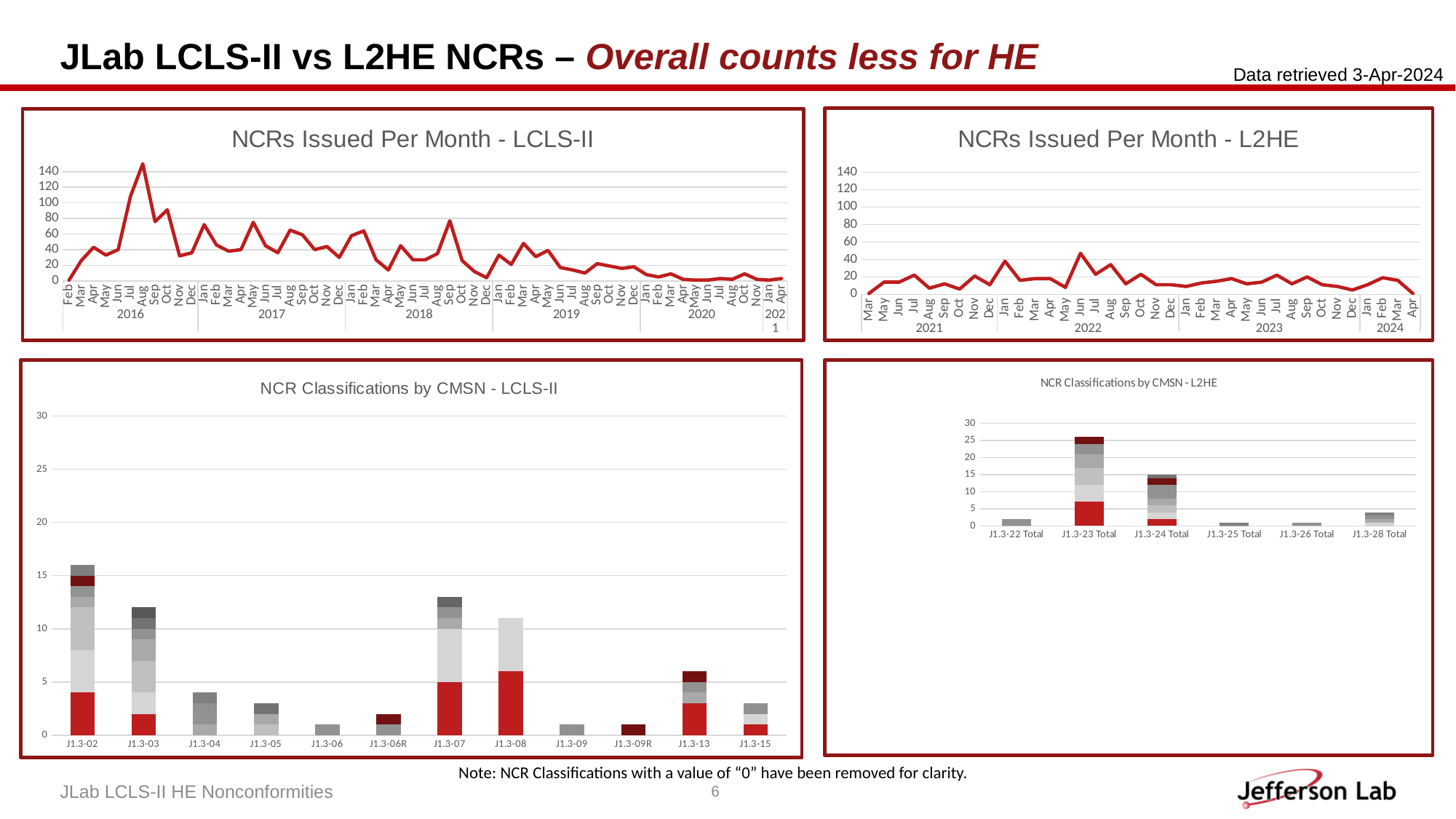
In "NCR Classifications by CMSN - L2HE", which is larger, the total for J1.3-23 Total or J1.3-24 Total? J1.3-23 Total In "NCR Classifications by CMSN - LCLS-II", which category has the tallest stacked bar? J1.3-02 In "NCRs Issued Per Month - LCLS-II", do the monthly values generally rise or fall from 2016 to 2021? fall How many categories are shown on the x axis of "NCR Classifications by CMSN - LCLS-II"? 12 In "NCR Classifications by CMSN - L2HE", which category has the tallest stacked bar? J1.3-23 Total What type of chart is "NCR Classifications by CMSN - L2HE"? stacked bar chart In "NCRs Issued Per Month - LCLS-II", is the peak value in Aug 2016 greater or less than 140? greater In "NCRs Issued Per Month - L2HE", is the highest monthly value greater or less than 60? less In "NCR Classifications by CMSN - LCLS-II", is the total for J1.3-06 greater or less than 5? less What type of chart is "NCRs Issued Per Month - LCLS-II"? line chart How many categories are shown on the x axis of "NCR Classifications by CMSN - L2HE"? 6